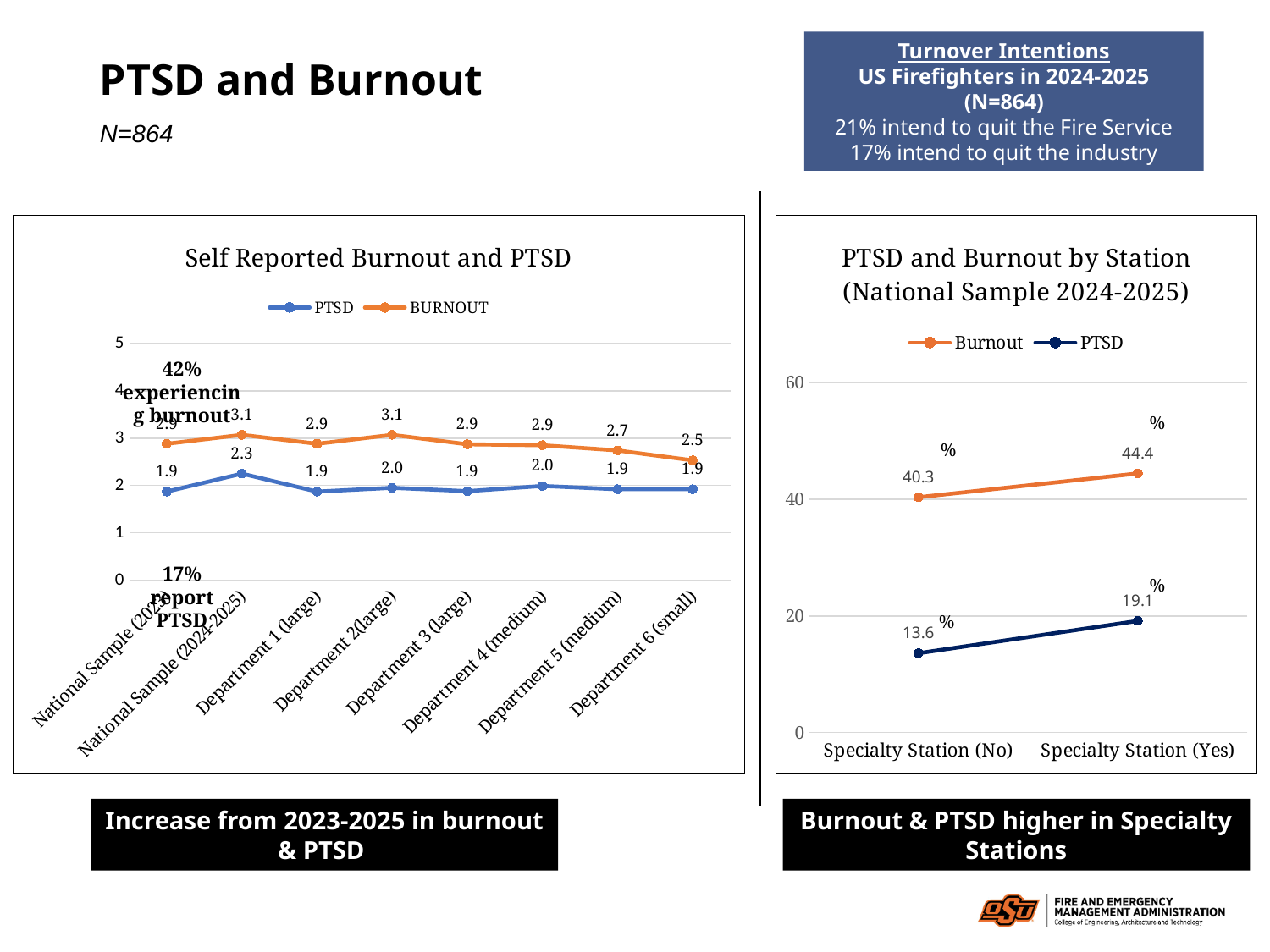
In the "PTSD and Burnout by Station" chart, what is the PTSD value for Specialty Station (No)? 13.6 In the "Self Reported Burnout and PTSD" chart, which category has the lowest BURNOUT value? Department 6 (small) How many series does the legend of the "Self Reported Burnout and PTSD" chart list? 2 In the "Self Reported Burnout and PTSD" chart, what is the difference between the BURNOUT values for Department 5 (medium) and Department 6 (small)? 0.2 In the "Self Reported Burnout and PTSD" chart, which category has the highest PTSD value? National Sample (2024-2025) In the "Self Reported Burnout and PTSD" chart, what is the PTSD value for National Sample (2024-2025)? 2.3 In the "PTSD and Burnout by Station" chart, does the Burnout line rise or fall from Specialty Station (No) to Specialty Station (Yes)? rise In the "PTSD and Burnout by Station" chart, what is the Burnout value for Specialty Station (Yes)? 44.4 In the "Self Reported Burnout and PTSD" chart, what is the BURNOUT value for Department 2 (large)? 3.1 How many categories are shown on the x axis of the "Self Reported Burnout and PTSD" chart? 8 In the "PTSD and Burnout by Station" chart, what is the difference between the PTSD values for Specialty Station (Yes) and Specialty Station (No)? 5.5 What kind of chart is the "Self Reported Burnout and PTSD" chart on the left? line chart